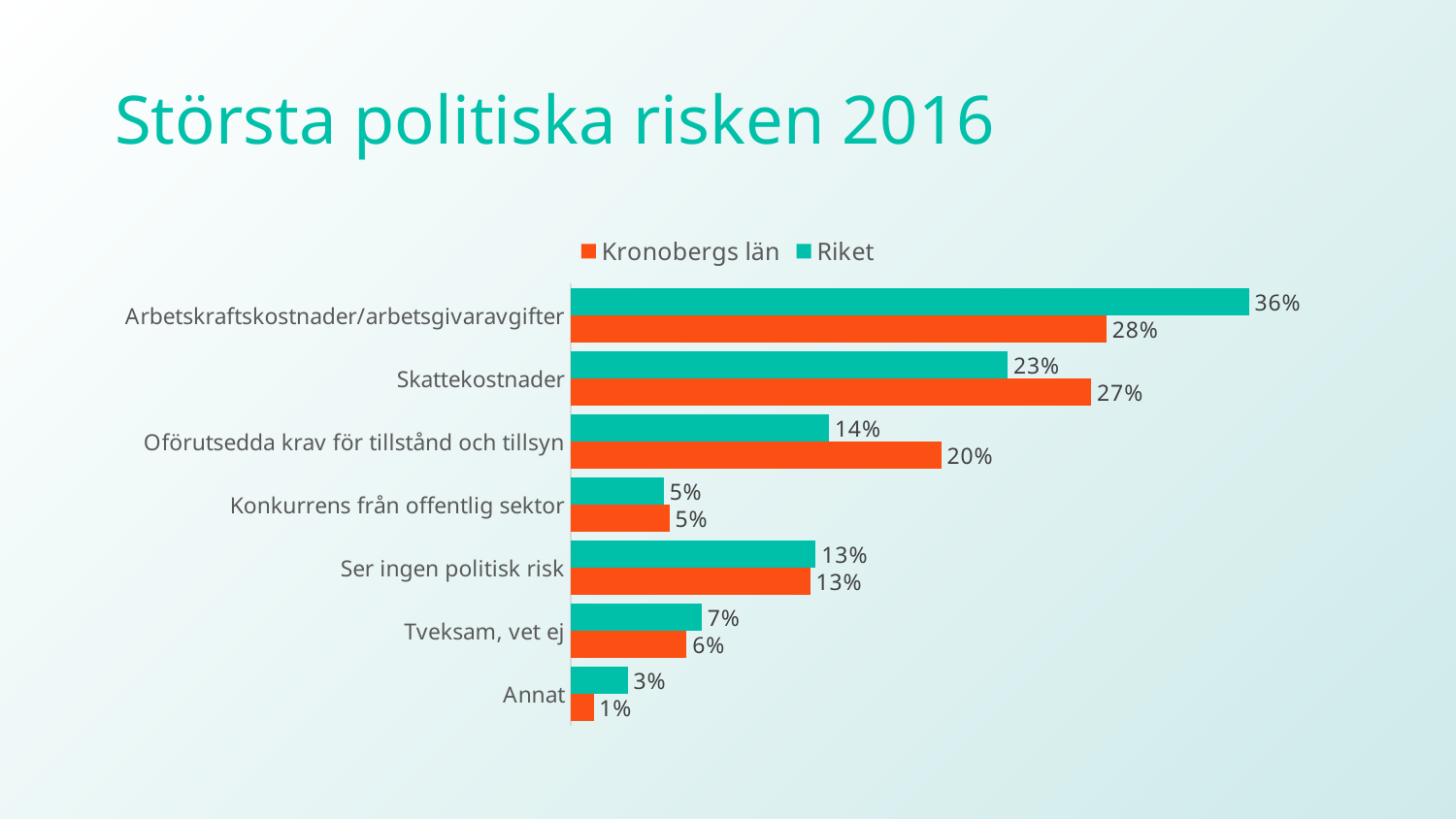
What is the difference between the Kronobergs län and Riket values for Oförutsedda krav för tillstånd och tillsyn? 6% For Skattekostnader, which series has the larger value, Kronobergs län or Riket? Kronobergs län How many categories are shown on the chart? 7 Which category has the highest value for Riket? Arbetskraftskostnader/arbetsgivaravgifter What is the difference between the Riket and Kronobergs län values for Arbetskraftskostnader/arbetsgivaravgifter? 8% What is the value for Kronobergs län for Skattekostnader? 27% What is the value for Kronobergs län for Oförutsedda krav för tillstånd och tillsyn? 20% What kind of chart is shown on the slide? Bar chart How many series does the legend list? 2 Which category has the lowest value for Kronobergs län? Annat What is the value for Riket for Arbetskraftskostnader/arbetsgivaravgifter? 36% What is the value for Riket for Annat? 3%